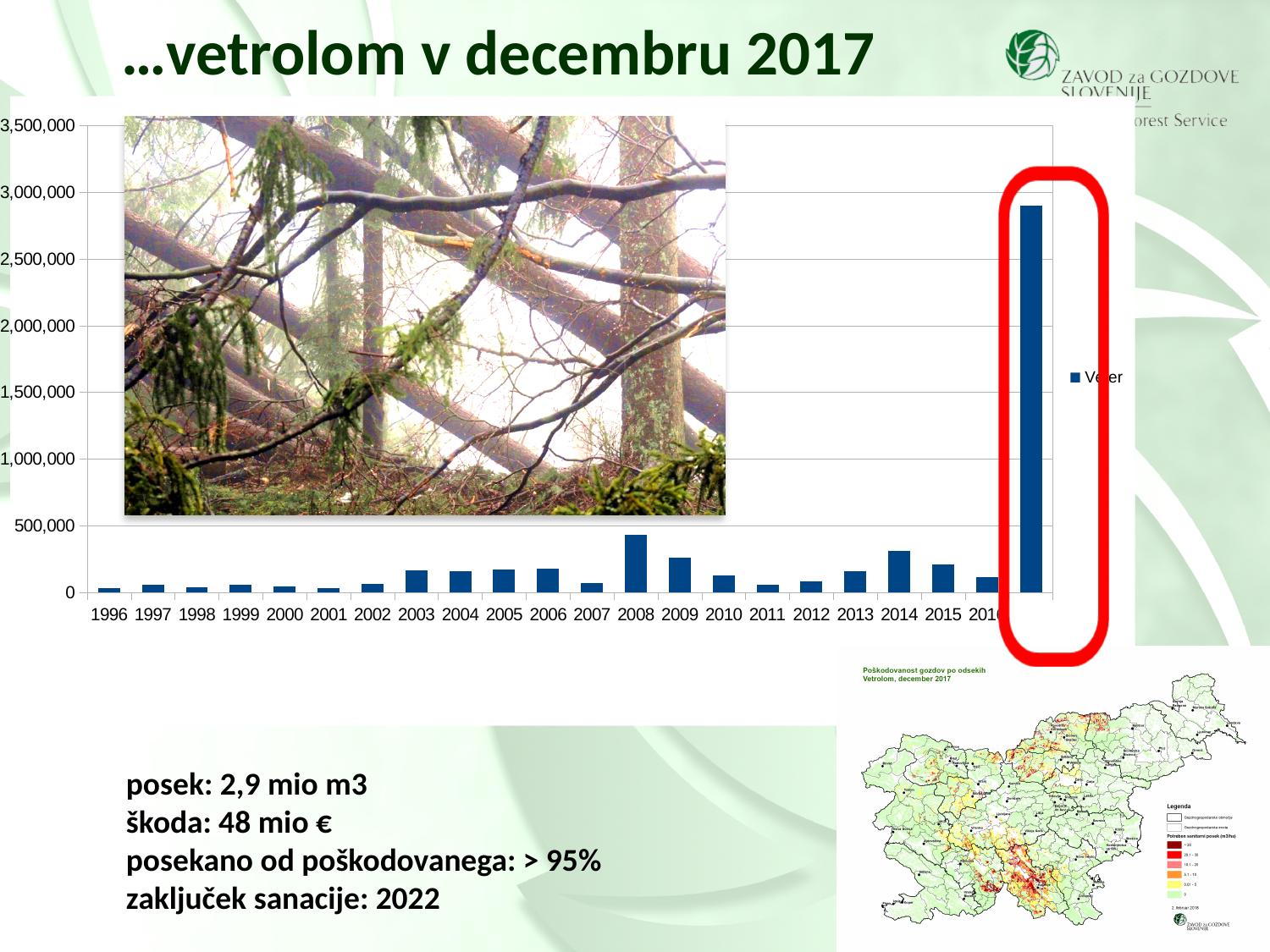
Which year has the larger value, 2013 or 2014? 2014 What is the highest value shown on the vertical axis of the chart? 3,500,000 Which year has the highest bar in the chart? 2017 Which year has the larger value, 2008 or 2009? 2008 Which year has the larger value, 2010 or 2011? 2010 Is the value for 2017 greater or less than 3,000,000? less Is the value for 2017 greater or less than 2,500,000? greater What kind of chart is shown on the slide? bar chart Is the value for 2008 greater or less than 500,000? less How many years (bars) are plotted in the chart? 22